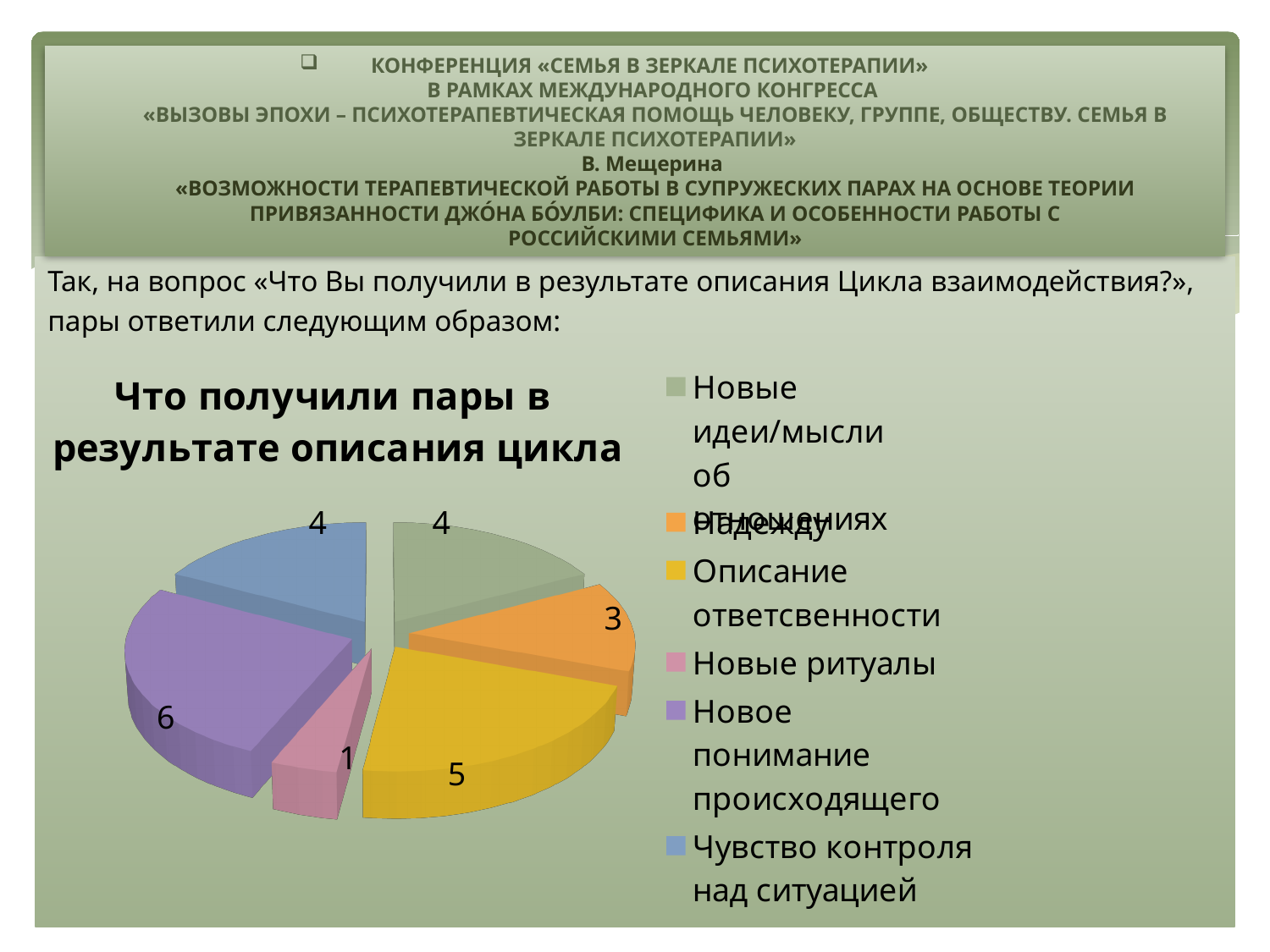
What is the total of all the values in the pie chart? 23 What is the value for «Надежду»? 3 How many categories does the pie chart have? 6 What is the value for «Описание ответсвенности»? 5 What is the value for «Новое понимание происходящего»? 6 What is the difference between the values for «Новое понимание происходящего» and «Новые ритуалы»? 5 Which category has the smallest value? Новые ритуалы Which category has the largest value? Новое понимание происходящего What is the title of the chart? Что получили пары в результате описания цикла What type of chart is shown on the slide? Pie chart Which is larger: the value for «Описание ответсвенности» or the value for «Надежду»? Описание ответсвенности What is the value for «Новые ритуалы»? 1